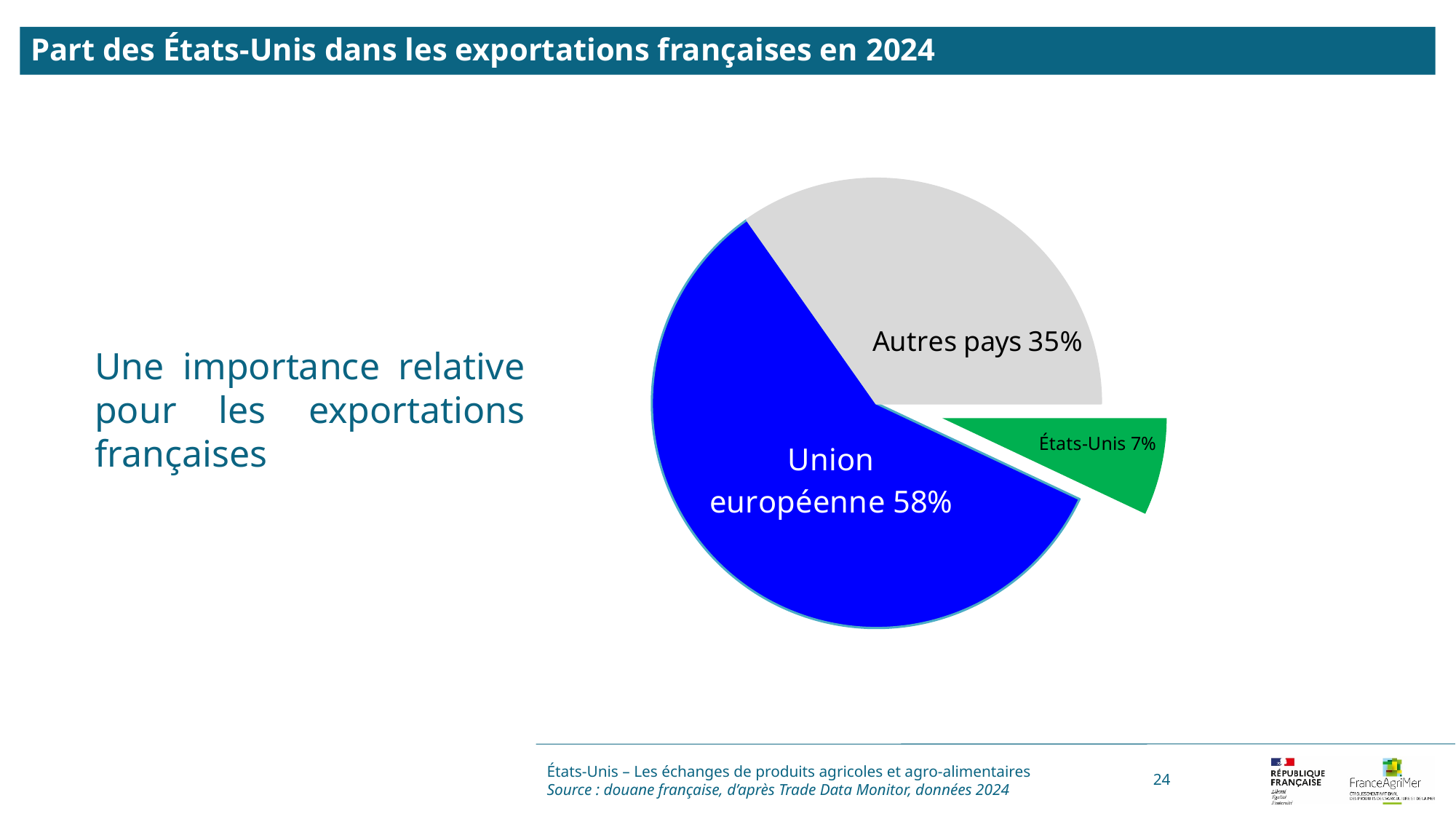
What share of French exports goes to the Union européenne? 58% What is the difference in percentage points between the Autres pays share and the États-Unis share? 28 Which slice of the pie is the smallest? États-Unis Which is larger, the share for Autres pays or the share for États-Unis? Autres pays What kind of chart is shown on the slide? Pie chart What share of French exports goes to the États-Unis? 7% Which slice of the pie is the largest? Union européenne What colour is the États-Unis slice? Green How many slices does the pie chart have? 3 What is the title of the slide containing the pie chart? Part des États-Unis dans les exportations françaises en 2024 What is the difference in percentage points between the Union européenne share and the Autres pays share? 23 What share of French exports goes to Autres pays? 35%